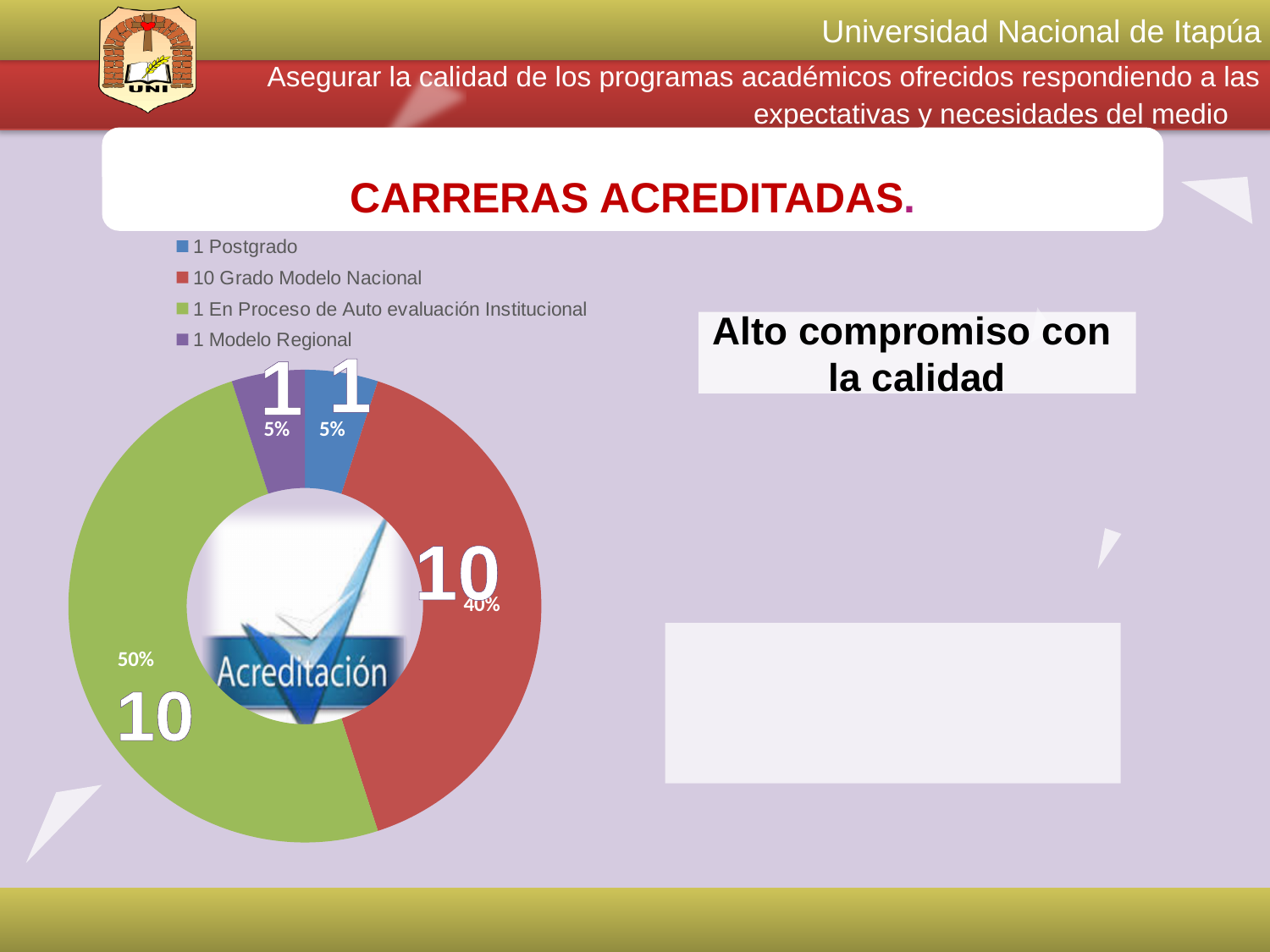
Which category has the largest slice of the chart? En Proceso de Auto evaluación Institucional What percentage is shown for the Postgrado slice? 5% What is the title shown above the chart? CARRERAS ACREDITADAS. What percentage is shown for the En Proceso de Auto evaluación Institucional slice? 50% What percentage is shown for the Modelo Regional slice? 5% What kind of chart is shown on the slide? Doughnut (pie) chart How many categories does the chart's legend list? 4 What is the difference in percentage points between the Grado Modelo Nacional slice and the Postgrado slice? 35% What percentage is shown for the Grado Modelo Nacional slice? 40% Which slice is larger, Grado Modelo Nacional or Postgrado? Grado Modelo Nacional What value is printed on the Grado Modelo Nacional slice? 10 What colour represents Grado Modelo Nacional in the chart? Red